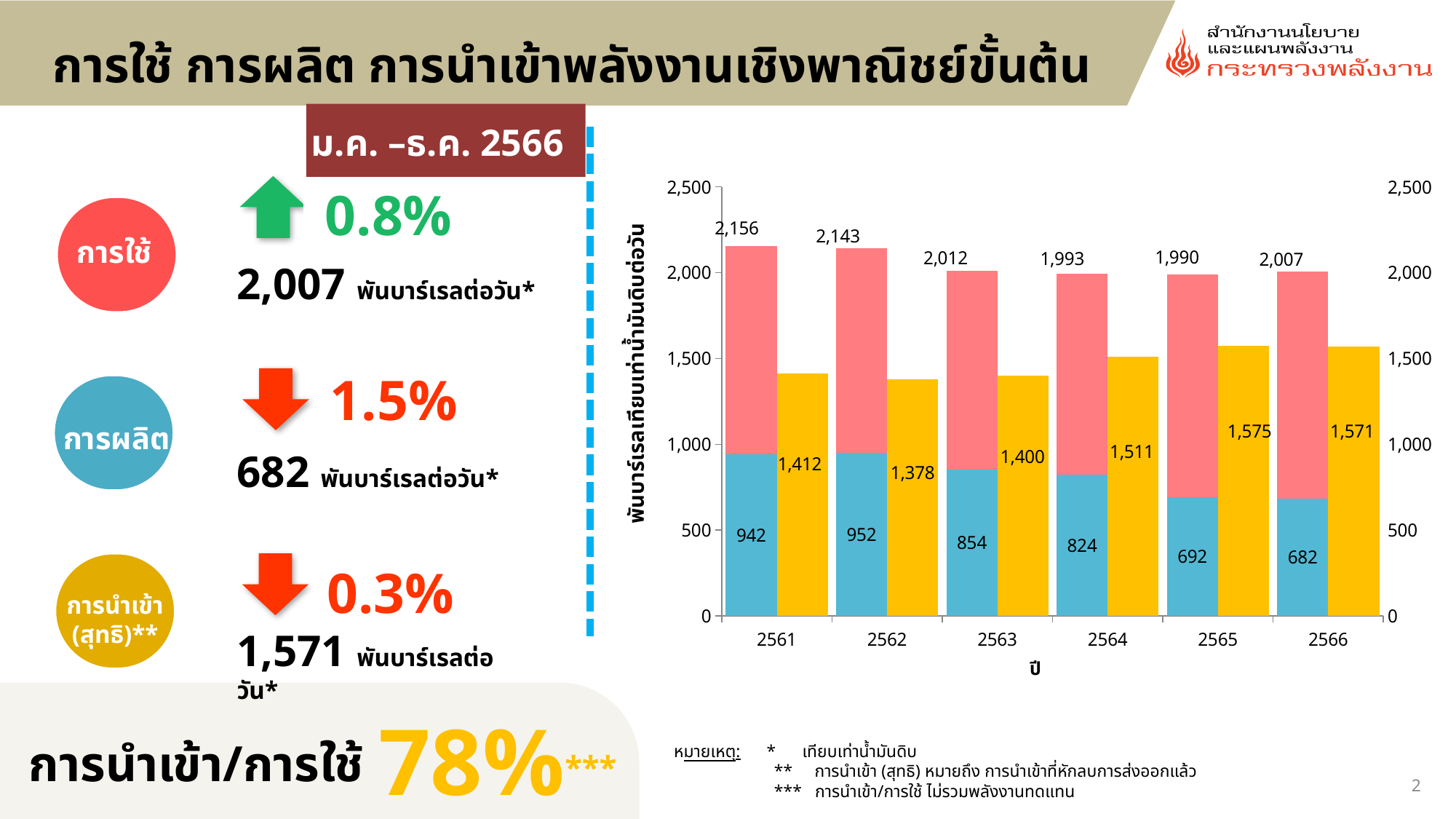
Is the value of the yellow bar for 2561 greater or less than 1,500? less What kind of chart is shown on the slide? bar chart How many years are shown on the x axis of the chart? 6 What is the value of the blue bar for 2566? 682 Which year has the highest red bar? 2561 What is the difference between the red bar values for 2561 and 2566? 149 Which year has the lowest blue bar? 2566 What is the value of the red bar for 2561? 2,156 Do the blue bars generally rise or fall from 2561 to 2566? fall What is the title of the x axis of the chart? ปี What is the value of the yellow bar for 2565? 1,575 Which year has the larger yellow bar, 2563 or 2564? 2564